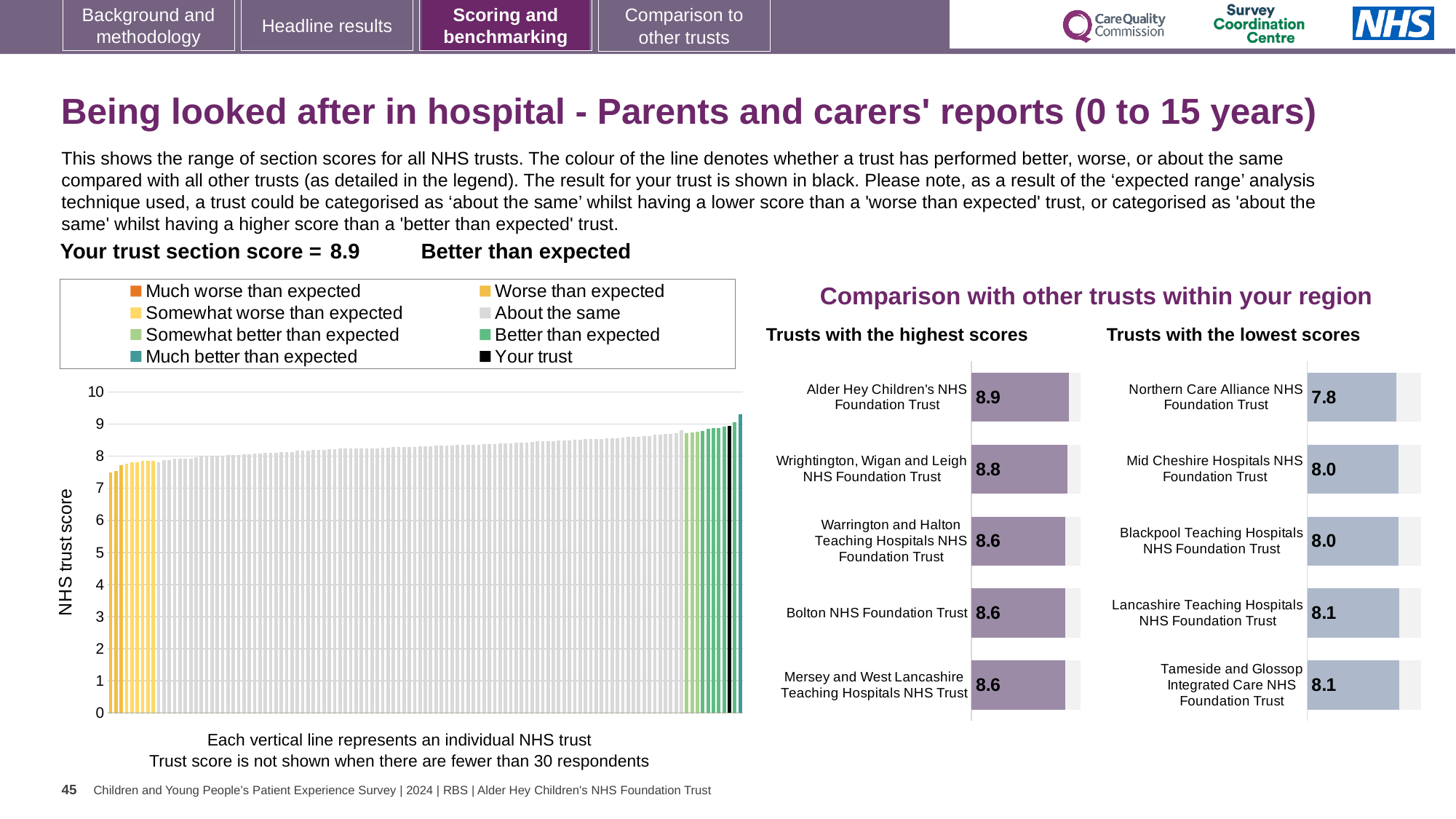
How many trusts are shown in the 'Trusts with the lowest scores' chart? 5 How many entries does the legend of the large chart on the left list? 8 In the 'Trusts with the highest scores' chart, what is the score for Wrightington, Wigan and Leigh NHS Foundation Trust? 8.8 In the 'Trusts with the lowest scores' chart, what is the score for Northern Care Alliance NHS Foundation Trust? 7.8 What kind of chart is the large chart on the left showing NHS trust scores? Bar chart In the 'Trusts with the lowest scores' chart, which has the larger score: Mid Cheshire Hospitals NHS Foundation Trust or Lancashire Teaching Hospitals NHS Foundation Trust? Lancashire Teaching Hospitals NHS Foundation Trust In the 'Trusts with the lowest scores' chart, what is the score for Lancashire Teaching Hospitals NHS Foundation Trust? 8.1 In the 'Trusts with the highest scores' chart, what is the difference between the scores of Alder Hey Children's NHS Foundation Trust and Warrington and Halton Teaching Hospitals NHS Foundation Trust? 0.3 In the 'Trusts with the lowest scores' chart, which trust has the lowest score? Northern Care Alliance NHS Foundation Trust In the large chart on the left, is the value for the black bar (your trust) greater or less than 8? greater In the 'Trusts with the highest scores' chart, which trust has the highest score? Alder Hey Children's NHS Foundation Trust In the 'Trusts with the highest scores' chart, what is the score for Alder Hey Children's NHS Foundation Trust? 8.9